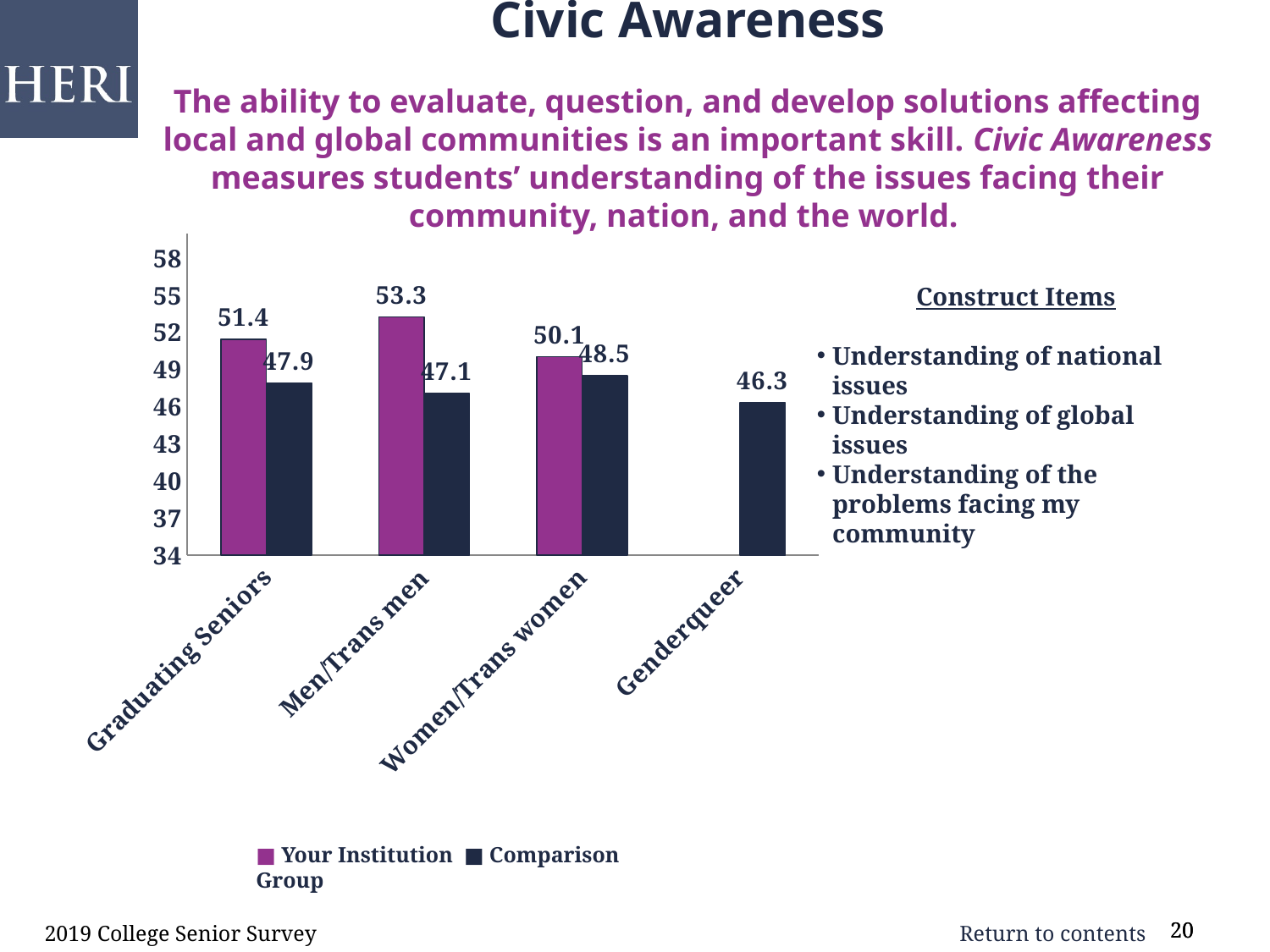
What is the difference between the Your Institution and Comparison Group values for Men/Trans men? 6.2 How many categories are shown on the x axis? 4 What is the Comparison Group value for Genderqueer? 46.3 Which is larger for Graduating Seniors: the Your Institution value or the Comparison Group value? Your Institution What is the Your Institution value for Women/Trans women? 50.1 How many series does the legend list? 2 Which category has the lowest Comparison Group value? Genderqueer What is the Your Institution value for Graduating Seniors? 51.4 What is the Comparison Group value for Men/Trans men? 47.1 What colour are the Comparison Group bars? Dark navy blue What kind of chart is shown on the slide? Bar chart Which category has the highest Your Institution value? Men/Trans men